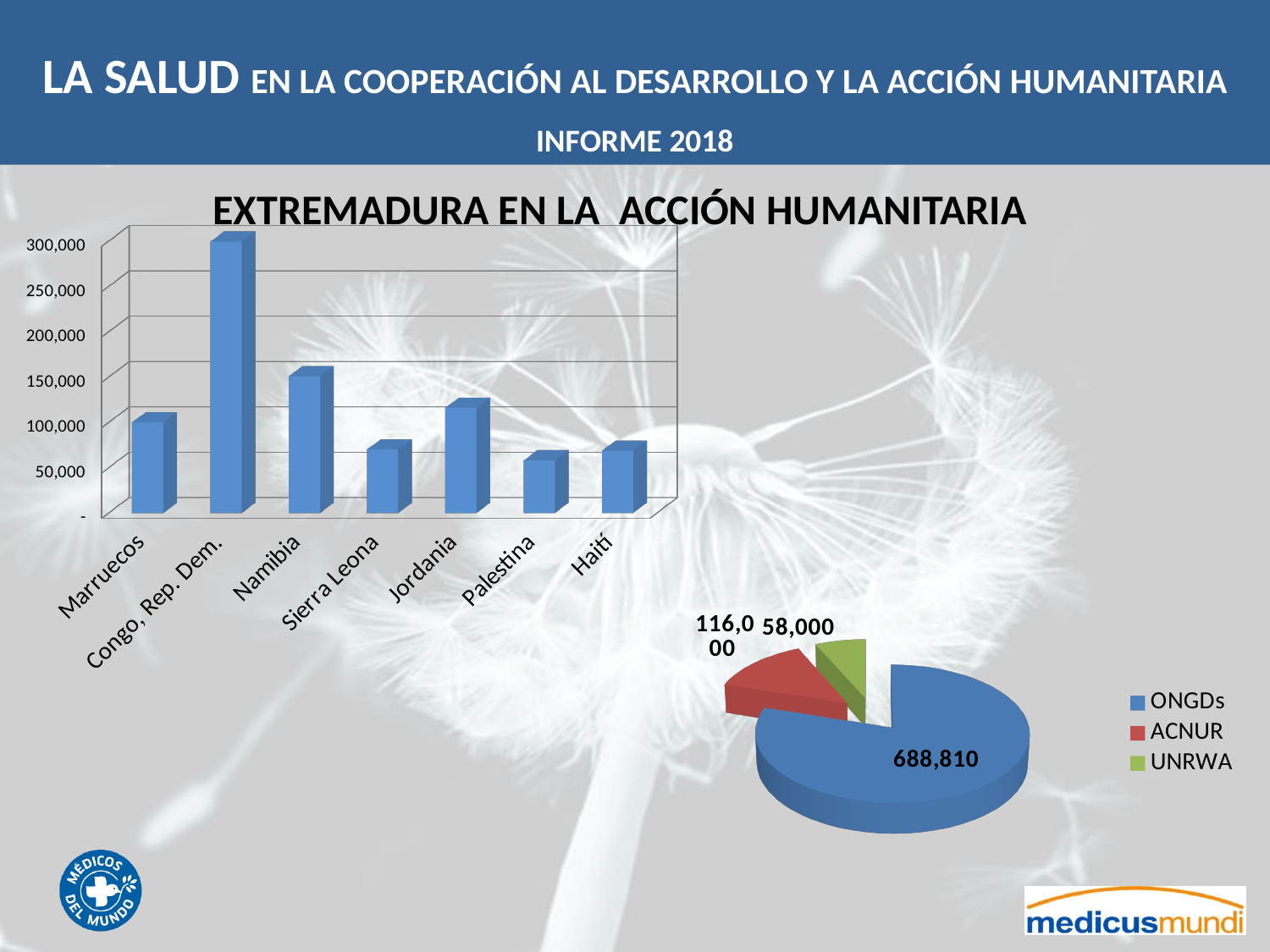
What kind of chart is the chart titled 'EXTREMADURA EN LA ACCIÓN HUMANITARIA'? Bar chart In the bar chart titled 'EXTREMADURA EN LA ACCIÓN HUMANITARIA', which is larger, the value for Namibia or the value for Jordania? Namibia In the bar chart titled 'EXTREMADURA EN LA ACCIÓN HUMANITARIA', which country has the highest value? Congo, Rep. Dem. In the bar chart titled 'EXTREMADURA EN LA ACCIÓN HUMANITARIA', which is larger, the value for Marruecos or the value for Palestina? Marruecos In the pie chart at the bottom right, what is the value for ACNUR? 116,000 In the bar chart titled 'EXTREMADURA EN LA ACCIÓN HUMANITARIA', is the value for Sierra Leona greater or less than 100,000? less In the bar chart titled 'EXTREMADURA EN LA ACCIÓN HUMANITARIA', how many countries are shown on the x axis? 7 In the pie chart at the bottom right, what is the difference between the ACNUR value and the UNRWA value? 58,000 In the pie chart at the bottom right, what is the value for ONGDs? 688,810 How many entries does the legend of the pie chart at the bottom right list? 3 In the bar chart titled 'EXTREMADURA EN LA ACCIÓN HUMANITARIA', is the value for Congo, Rep. Dem. greater or less than 250,000? greater In the bar chart titled 'EXTREMADURA EN LA ACCIÓN HUMANITARIA', is the value for Namibia greater or less than 100,000? greater